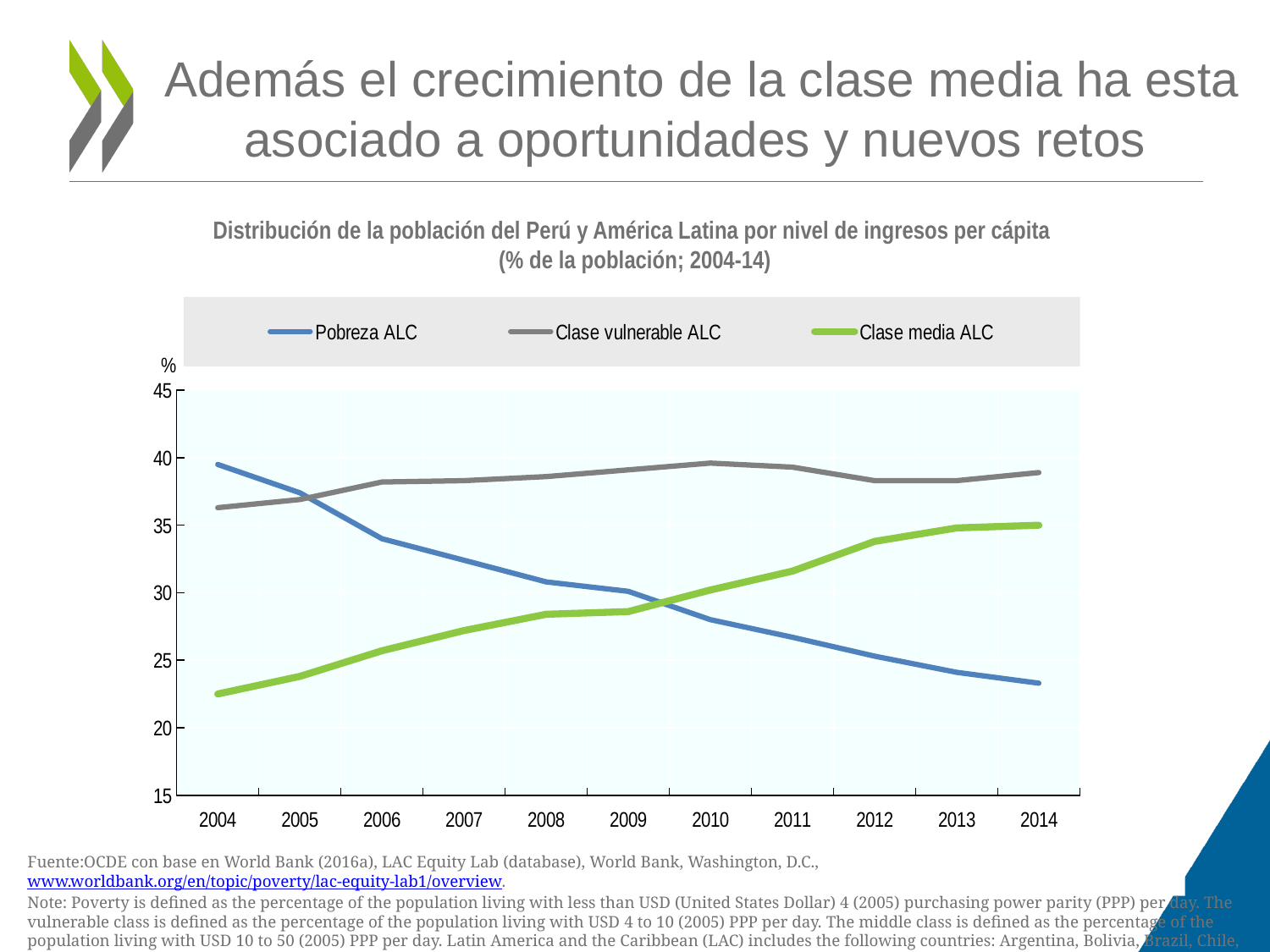
How many years are plotted along the x axis? 11 How many series does the legend list? 3 Does the Pobreza ALC line rise or fall from 2004 to 2014? fall Is the value for Pobreza ALC in 2004 greater or less than 35? greater Is the value for Clase vulnerable ALC in 2010 greater or less than 35? greater In 2004, which is larger: Pobreza ALC or Clase media ALC? Pobreza ALC Is the value for Pobreza ALC in 2014 greater or less than 25? less Which series has the lowest value in 2004? Clase media ALC What kind of chart is shown on the slide? line chart Does the Clase media ALC line rise or fall from 2004 to 2014? rise Which series has the highest value in 2014? Clase vulnerable ALC